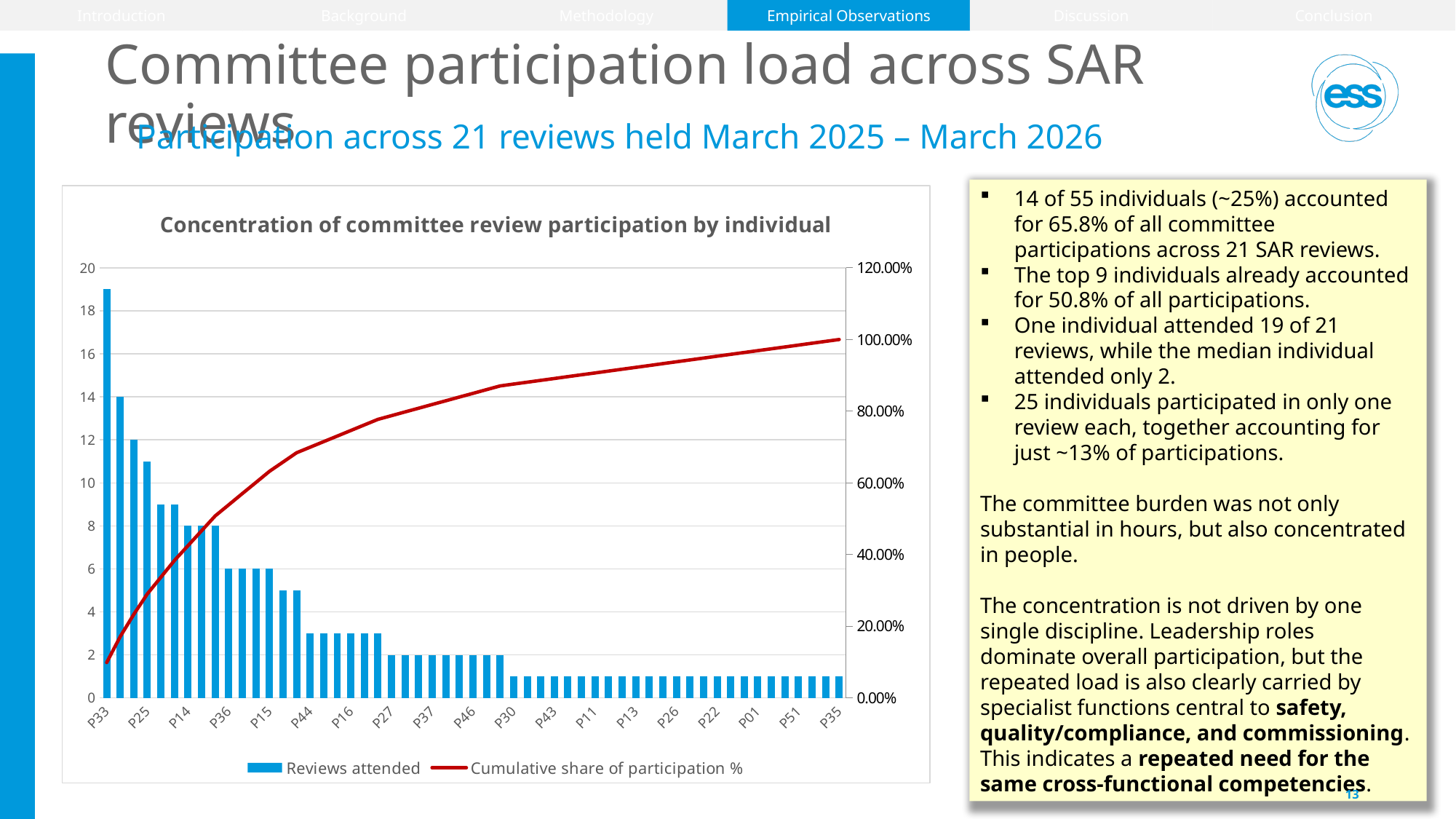
Is the number of reviews attended by P30 greater or less than 2? less Do the Reviews attended bars rise or fall from left to right along the x axis? fall What is the difference in reviews attended between P14 and P36? 2 Which individual has the highest number of reviews attended? P33 Which attended more reviews, P36 or P27? P36 How many reviews did P14 attend? 8 Is the number of reviews attended by P25 greater or less than 10? greater How many series does the chart legend list? 2 What is the title of the chart? Concentration of committee review participation by individual How many reviews did P36 attend? 6 How many reviews did P33 attend? 19 What type of chart is shown on the slide? Combined bar and line chart